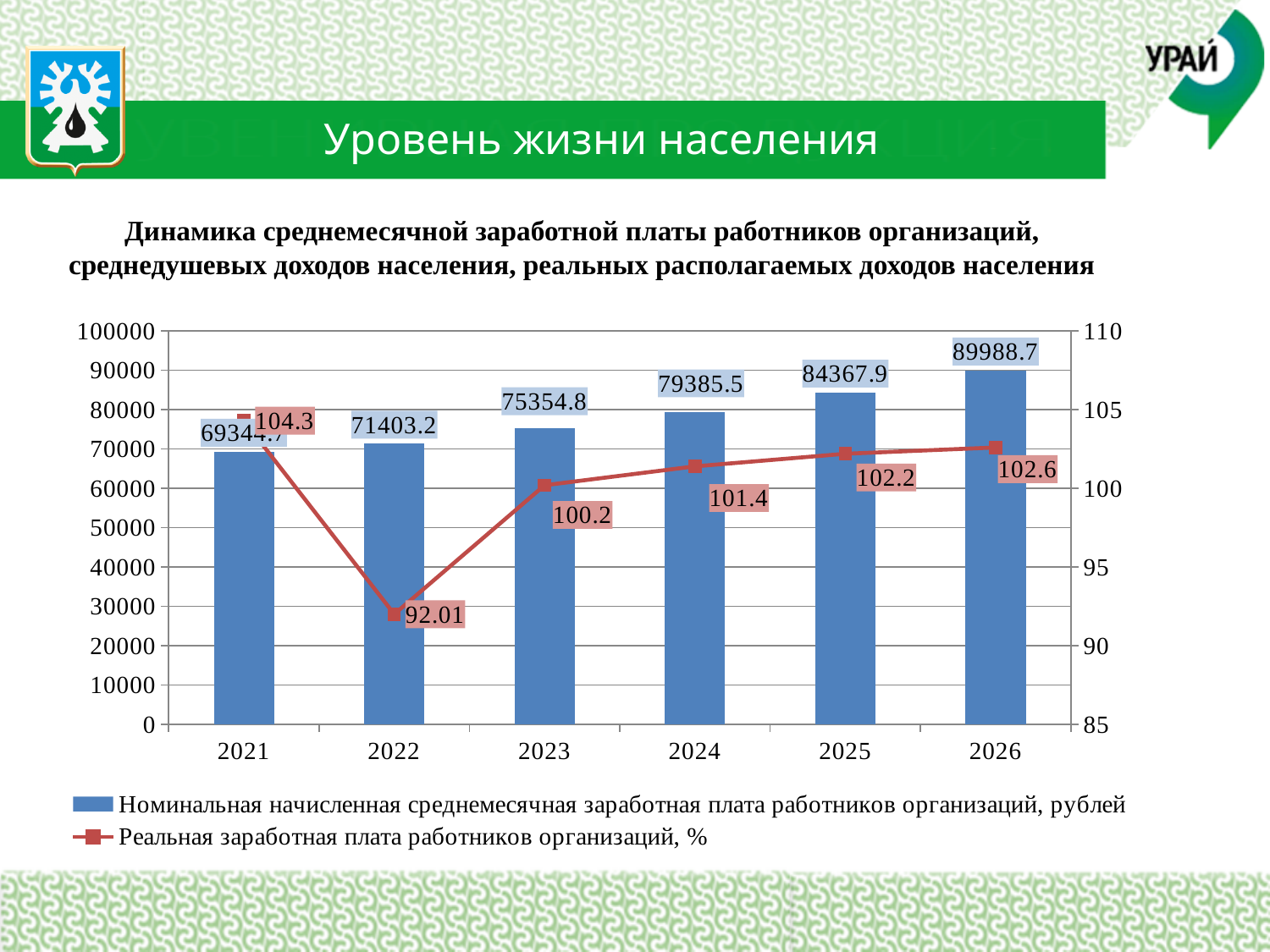
What is the difference between the nominal average monthly wage in 2026 and in 2025? 5620.8 In which year is the real wage percentage the lowest? 2022 How many series does the chart legend list? 2 What is the real wage percentage (Реальная заработная плата) shown for 2022? 92.01 What is the real wage percentage shown for 2025? 102.2 Which year has a higher real wage percentage, 2021 or 2023? 2021 What is the nominal average monthly wage (Номинальная начисленная среднемесячная заработная плата) shown for 2026? 89988.7 How many years are shown on the x axis of the chart? 6 What is the nominal average monthly wage shown for 2024? 79385.5 Is the nominal average monthly wage for 2023 greater or less than 80000? less Do the nominal average monthly wage bars rise or fall from 2021 to 2026? rise In which year is the nominal average monthly wage the highest? 2026